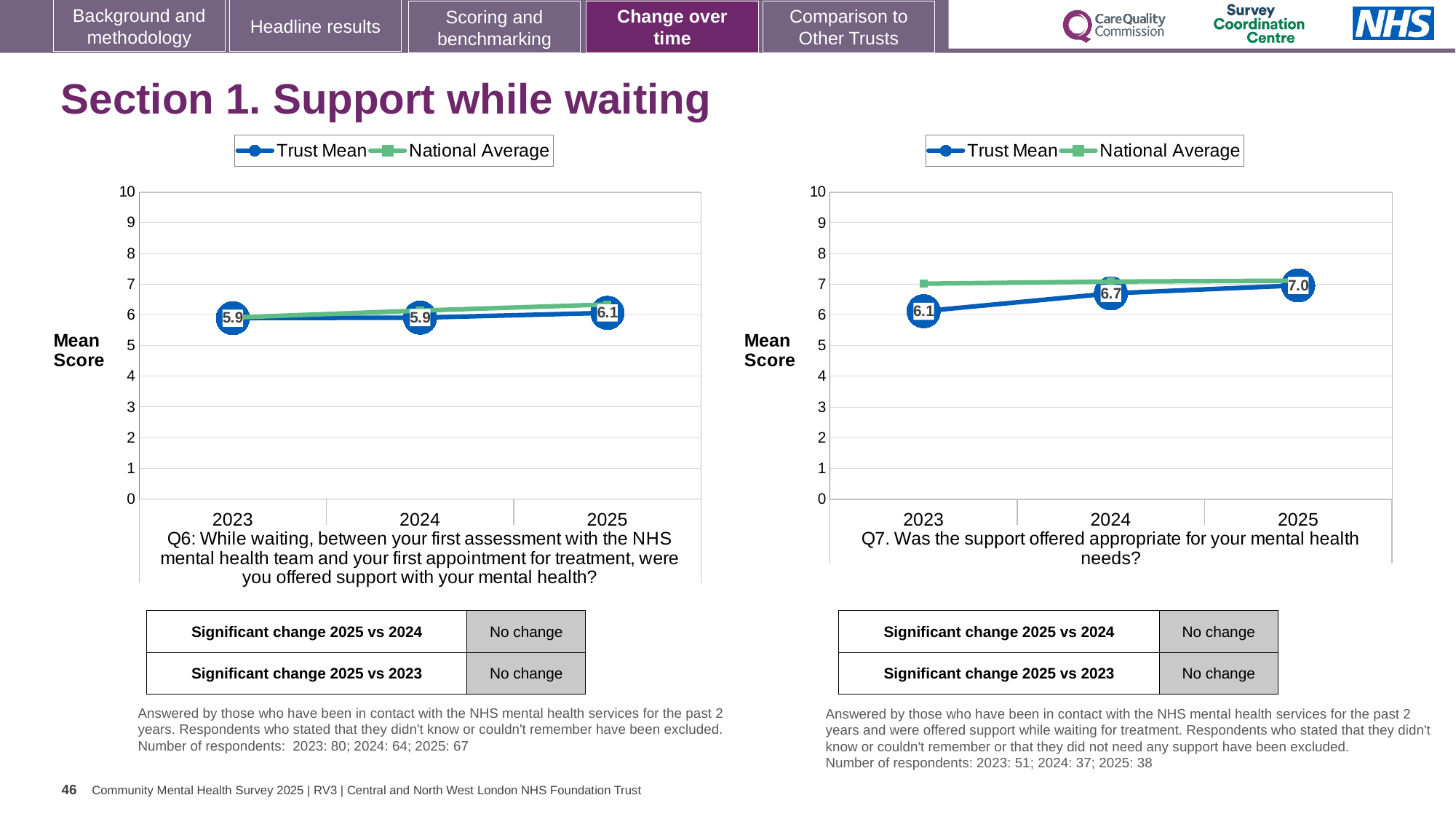
In the Q7 chart on the right, what is the Trust Mean for 2025? 7.0 In the Q6 chart on the left, what is the difference between the Trust Mean for 2025 and the Trust Mean for 2024? 0.2 In the Q7 chart on the right, which is larger in 2023, the Trust Mean or the National Average? National Average How many series does the legend of the Q6 chart on the left list? 2 In the Q7 chart on the right, does the Trust Mean rise or fall from 2023 to 2025? rise In the Q6 chart on the left, what is the Trust Mean for 2023? 5.9 In the Q7 chart on the right, is the National Average for 2023 greater or less than 5? greater In the Q7 chart on the right, what is the difference between the Trust Mean for 2025 and the Trust Mean for 2023? 0.9 In the Q7 chart on the right, which year has the lowest Trust Mean? 2023 In the Q6 chart on the left, what is the Trust Mean for 2025? 6.1 In the Q7 chart on the right, what is the Trust Mean for 2024? 6.7 In the Q7 chart on the right, which year has the highest Trust Mean? 2025